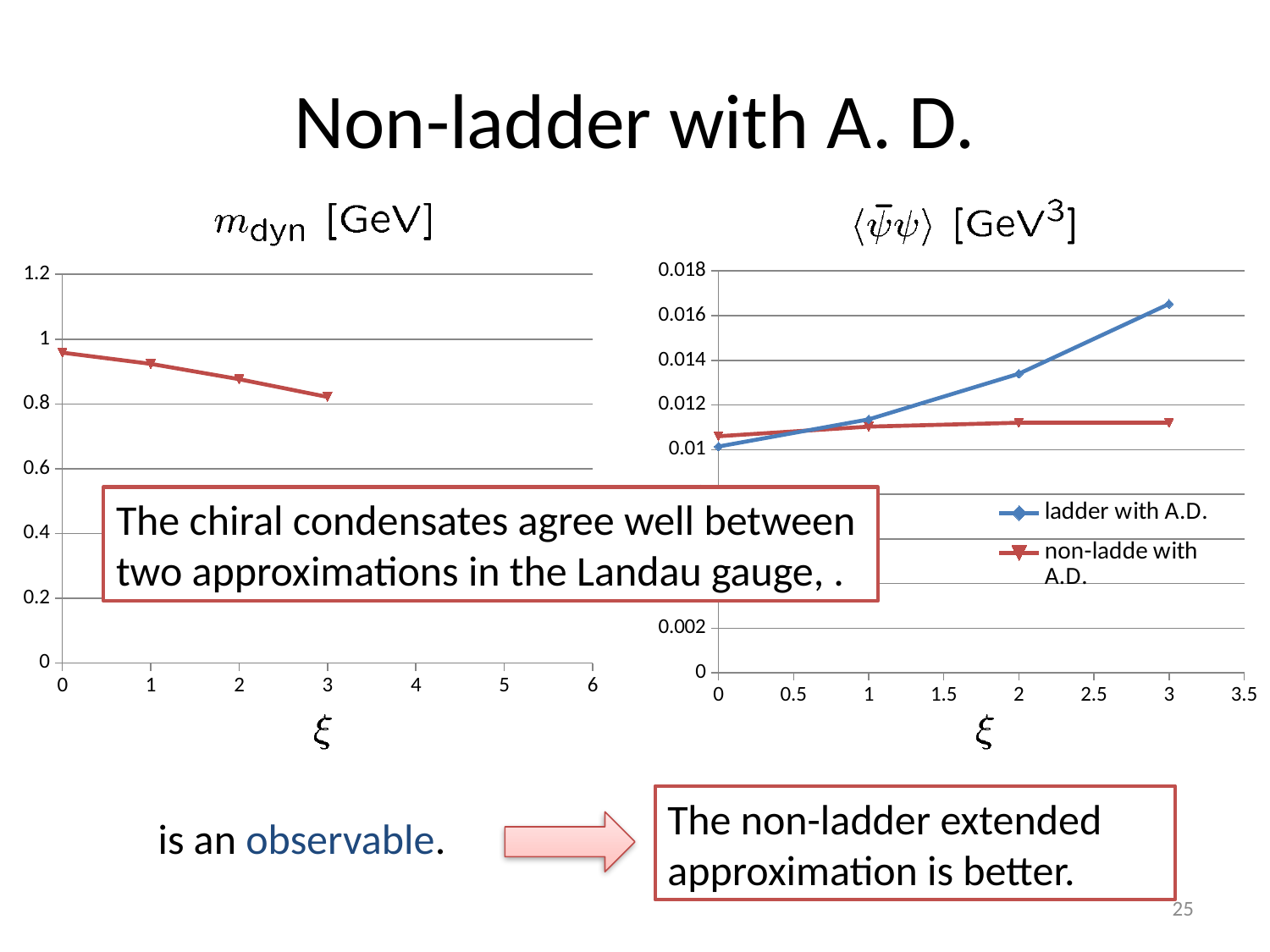
In the right chart (⟨ψ̄ψ⟩ [GeV³]), is the value of ladder with A.D. at ξ = 3 greater or less than 0.014? greater In the left chart (m_dyn [GeV]), do the values rise or fall as ξ increases? fall In the left chart (m_dyn [GeV]), is the value at ξ = 0 greater or less than 1? less In the left chart (m_dyn [GeV]), at which value of ξ is m_dyn lowest? 3 What kind of chart is the left chart titled m_dyn [GeV]? line chart In the left chart (m_dyn [GeV]), is the value at ξ = 1 greater or less than 0.8? greater In the right chart (⟨ψ̄ψ⟩ [GeV³]), which colour is used for the ladder with A.D. series? blue In the left chart (m_dyn [GeV]), at which value of ξ is m_dyn highest? 0 In the right chart (⟨ψ̄ψ⟩ [GeV³]), which series has the larger value at ξ = 3, ladder with A.D. or non-ladder with A.D.? ladder with A.D. In the right chart (⟨ψ̄ψ⟩ [GeV³]), do the values of the ladder with A.D. series rise or fall as ξ increases? rise How many data points are plotted in the left chart (m_dyn [GeV])? 4 How many series does the legend of the right chart (⟨ψ̄ψ⟩ [GeV³]) list? 2